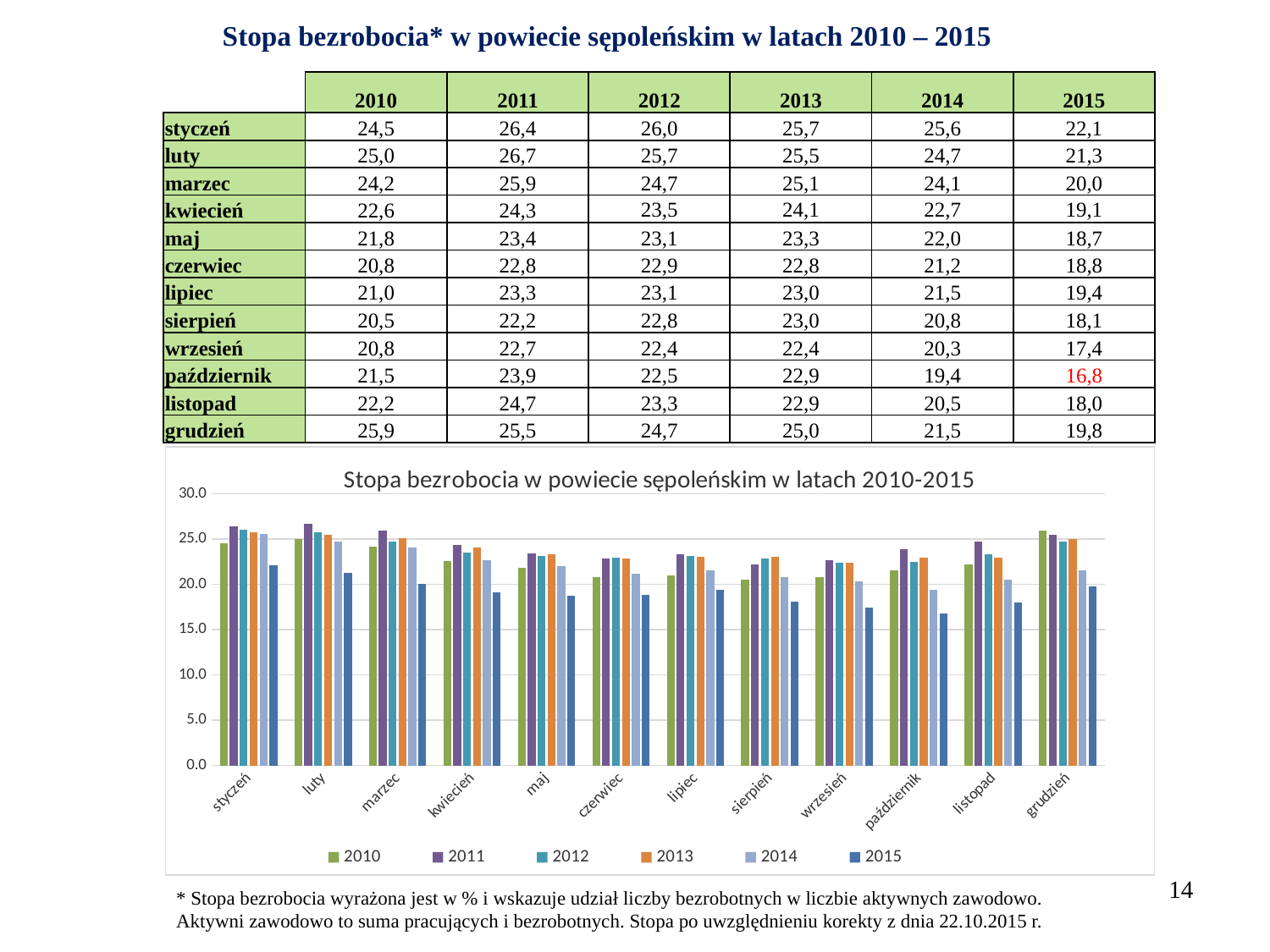
For grudzień, which year has the larger value, 2010 or 2015? 2010 Does the 2015 series rise or fall from styczeń to wrzesień? fall What is the difference between the styczeń values for 2010 and 2015? 2,4 How many month categories are shown along the x axis of the chart? 12 What is the unemployment rate for październik in 2015? 16,8 What is the title of the chart? Stopa bezrobocia w powiecie sępoleńskim w latach 2010-2015 Which month has the lowest value in the 2015 series? październik What kind of chart is shown on the slide? bar chart What is the unemployment rate for maj in 2013? 23,3 How many series does the chart legend list? 6 Is the value for wrzesień in the 2015 series greater or less than 20.0? less Which month has the highest value in the 2011 series? luty